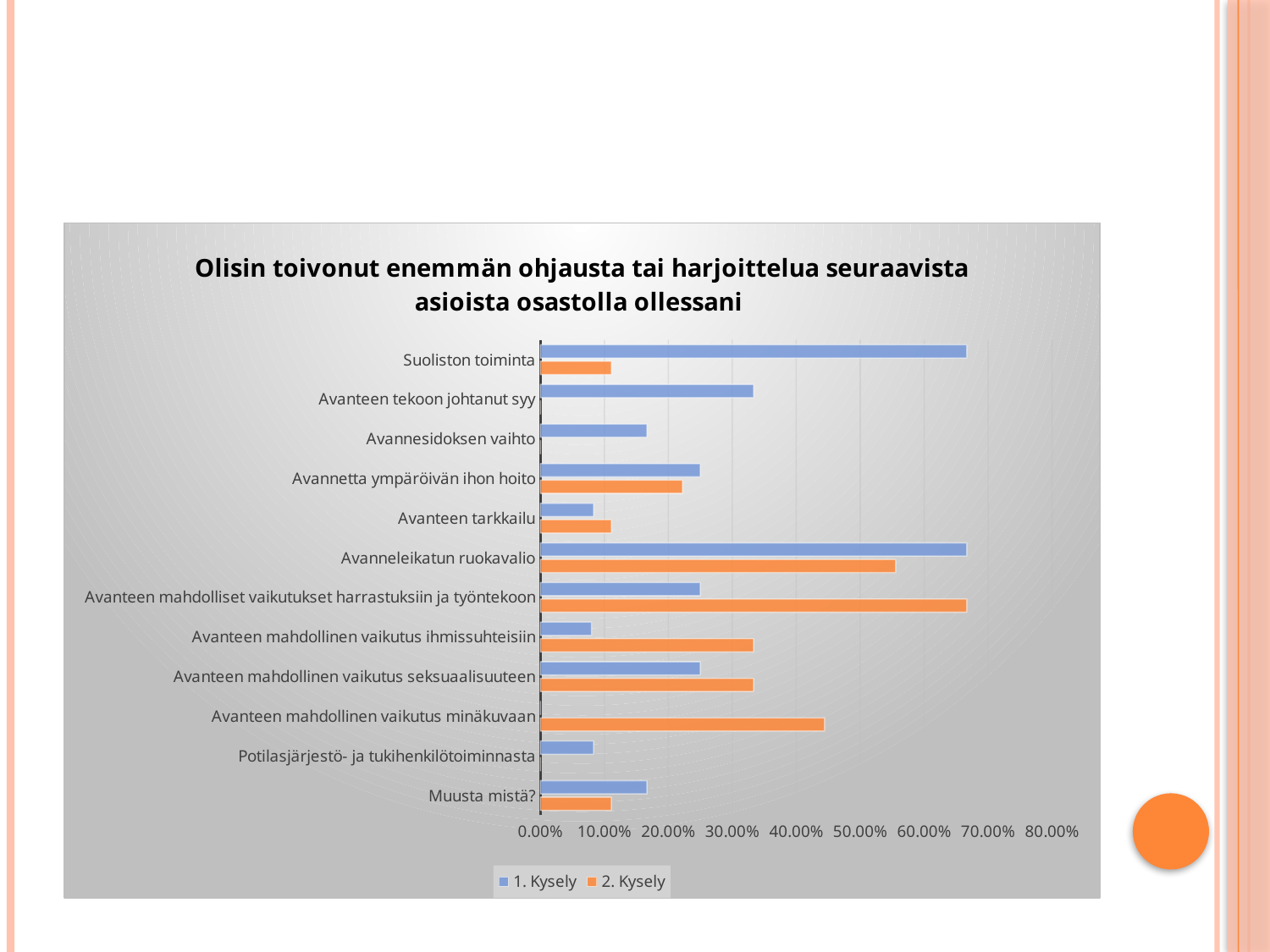
What is the title of the chart? Olisin toivonut enemmän ohjausta tai harjoittelua seuraavista asioista osastolla ollessani Is the 1. Kysely value for Suoliston toiminta greater or less than 60.00%? greater Is the 1. Kysely value for Avanteen tarkkailu greater or less than 10.00%? less What kind of chart is shown on the slide? bar chart For Suoliston toiminta, which series has the larger value, 1. Kysely or 2. Kysely? 1. Kysely Which colour represents the 2. Kysely series in the chart? orange Which category has the highest value for 2. Kysely? Avanteen mahdolliset vaikutukset harrastuksiin ja työntekoon Is the 2. Kysely value for Avanneleikatun ruokavalio greater or less than 50.00%? greater How many categories are shown on the chart? 12 For Avanteen mahdollinen vaikutus ihmissuhteisiin, which series has the larger value, 1. Kysely or 2. Kysely? 2. Kysely How many series does the legend list? 2